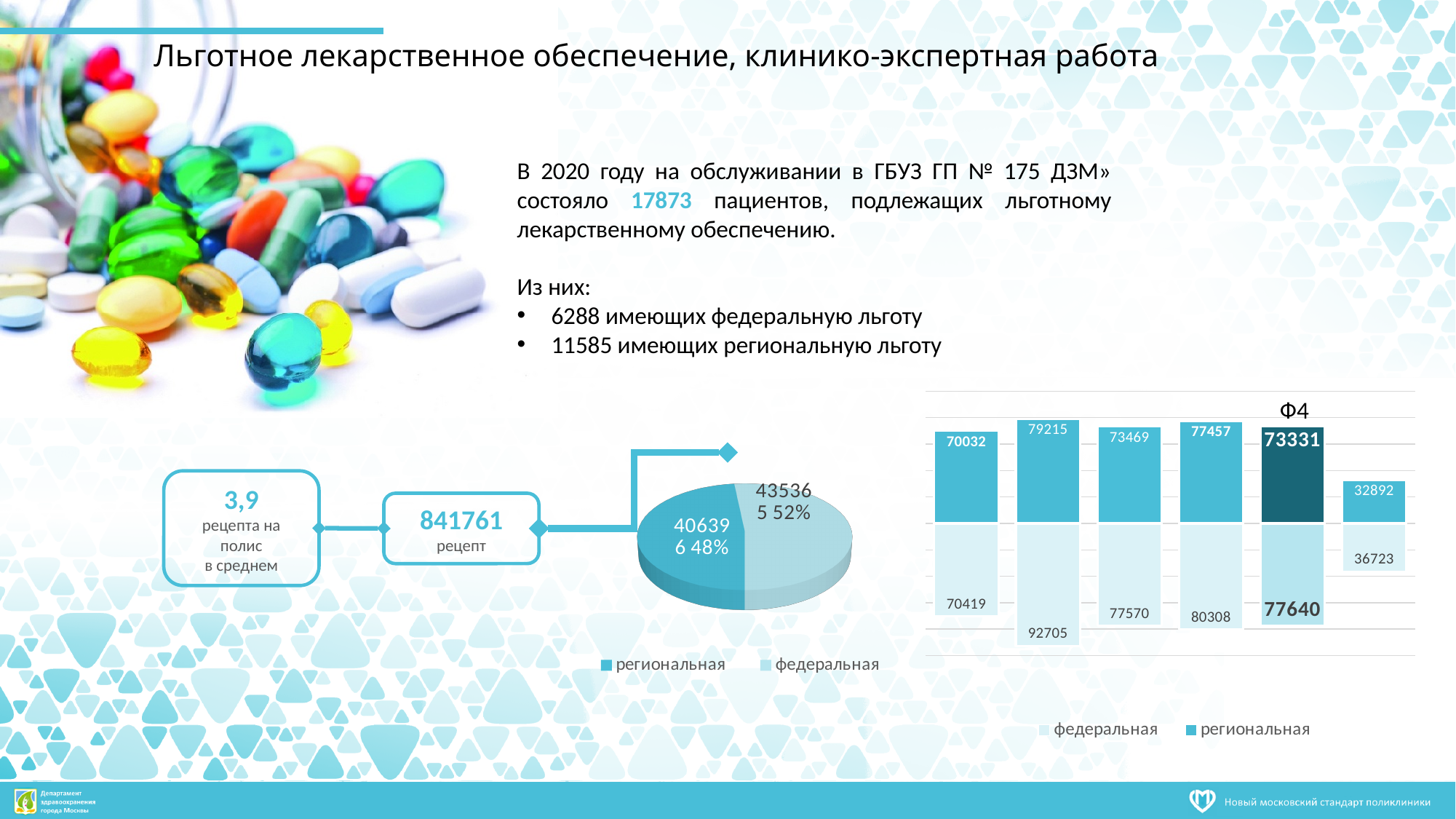
How many series does the legend of the bar chart on the right list? 2 How many stacked bars are shown in the bar chart on the right? 6 In the pie chart, what is the value of the 'региональная' slice? 406396 What kind of chart is the chart on the right of the slide? bar chart What kind of chart is the chart on the left with the legend 'региональная' and 'федеральная'? pie chart In the bar chart on the right, which is larger for the bar labelled Ф4, 'федеральная' or 'региональная'? федеральная In the bar chart on the right, what is the total of the stacked bar labelled Ф4? 150971 In the bar chart on the right, what is the 'региональная' value for the bar labelled Ф4? 73331 In the pie chart, what share does the 'федеральная' slice have? 52% In the pie chart, which slice is larger, 'региональная' or 'федеральная'? федеральная In the bar chart on the right, what is the highest 'федеральная' value shown? 92705 In the pie chart, what is the difference between the 'федеральная' value (435365) and the 'региональная' value (406396)? 28969